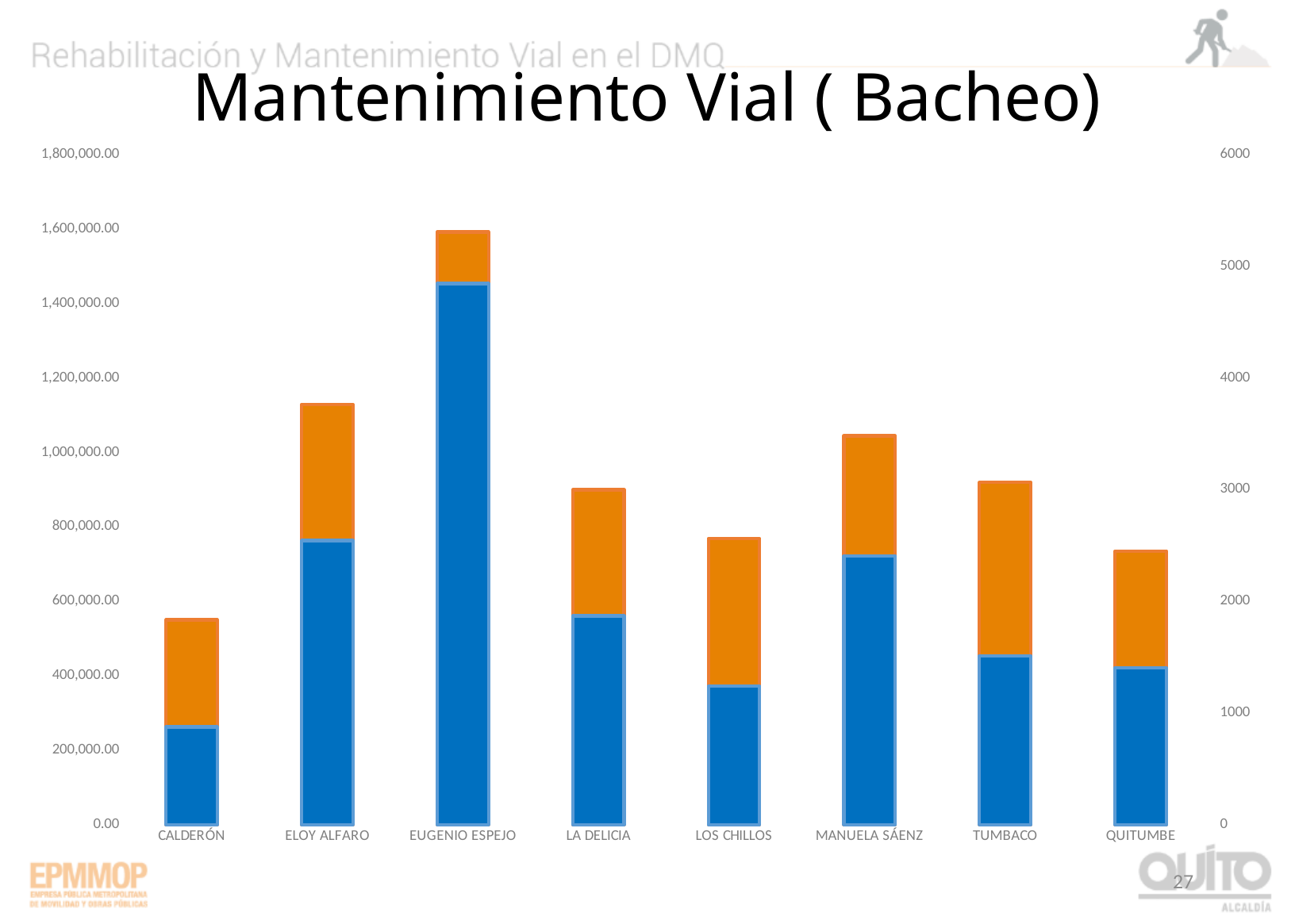
Is the total bar height for CALDERÓN greater or less than 600,000.00 on the left axis? less Which has the taller blue segment, LA DELICIA or TUMBACO? LA DELICIA How many categories (administrative zones) are shown on the x axis? 8 Is the total bar height for ELOY ALFARO greater or less than 1,000,000.00 on the left axis? greater Which category has the shortest bar overall? CALDERÓN Which category has the tallest bar overall? EUGENIO ESPEJO Is the total bar height for LOS CHILLOS greater or less than 800,000.00 on the left axis? less What kind of chart is shown on the slide? Bar chart Which has the taller total bar, TUMBACO or QUITUMBE? TUMBACO What is the title of the chart? Mantenimiento Vial ( Bacheo)